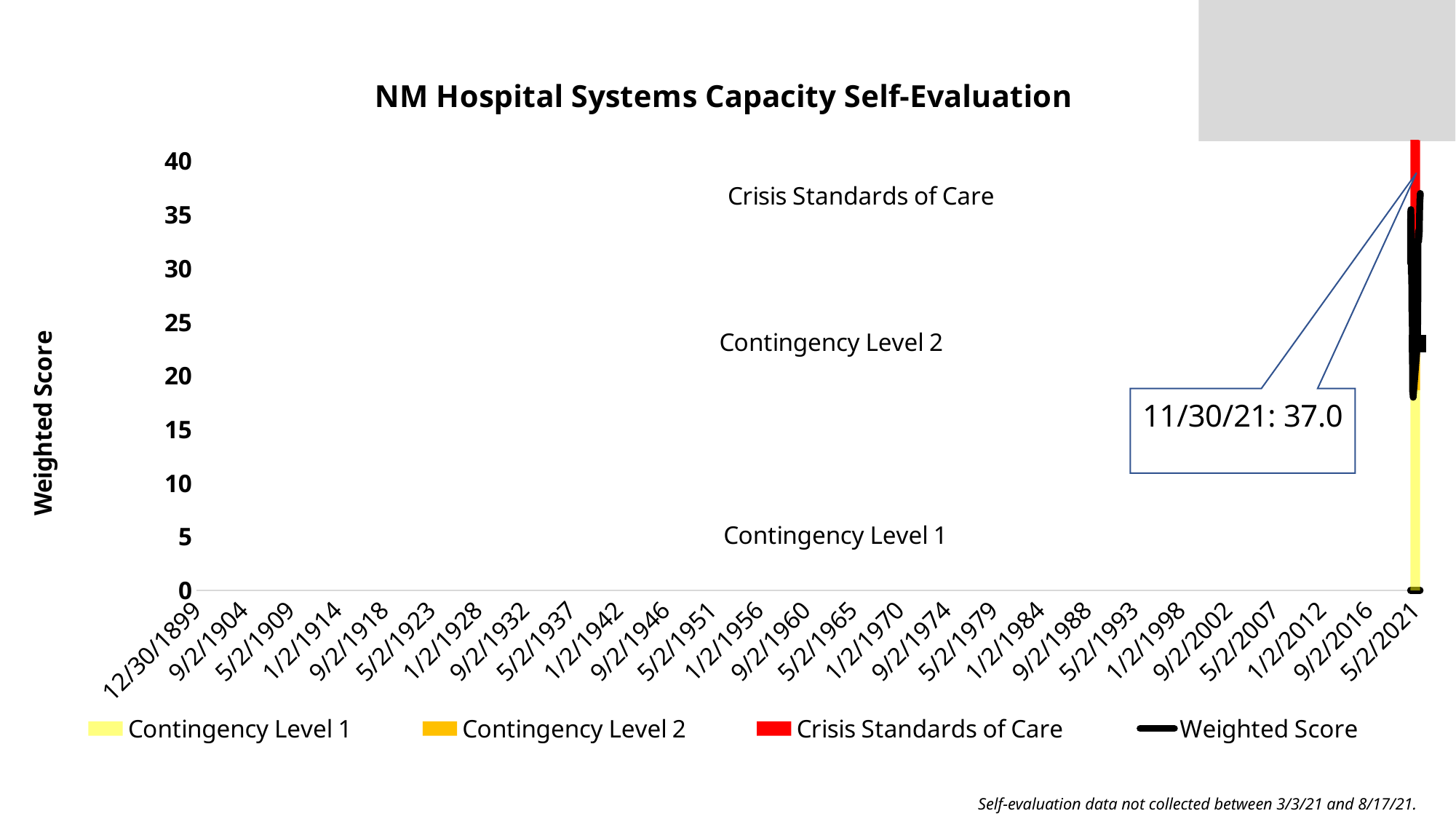
What is the label on the vertical axis? Weighted Score How many series does the legend list? 4 What is the title of the chart? NM Hospital Systems Capacity Self-Evaluation What is the highest tick value shown on the vertical axis? 40 Which legend series is shown in red? Crisis Standards of Care Between which two dates does the footnote say self-evaluation data was not collected? 3/3/21 and 8/17/21 Which legend series is drawn as a black line? Weighted Score What is the first date label on the horizontal axis? 12/30/1899 Which legend series is shown in yellow? Contingency Level 1 What is the last date label on the horizontal axis? 5/2/2021 Is the annotated weighted score for 11/30/21 greater or less than 35? greater What weighted score is called out in the annotation for 11/30/21? 37.0